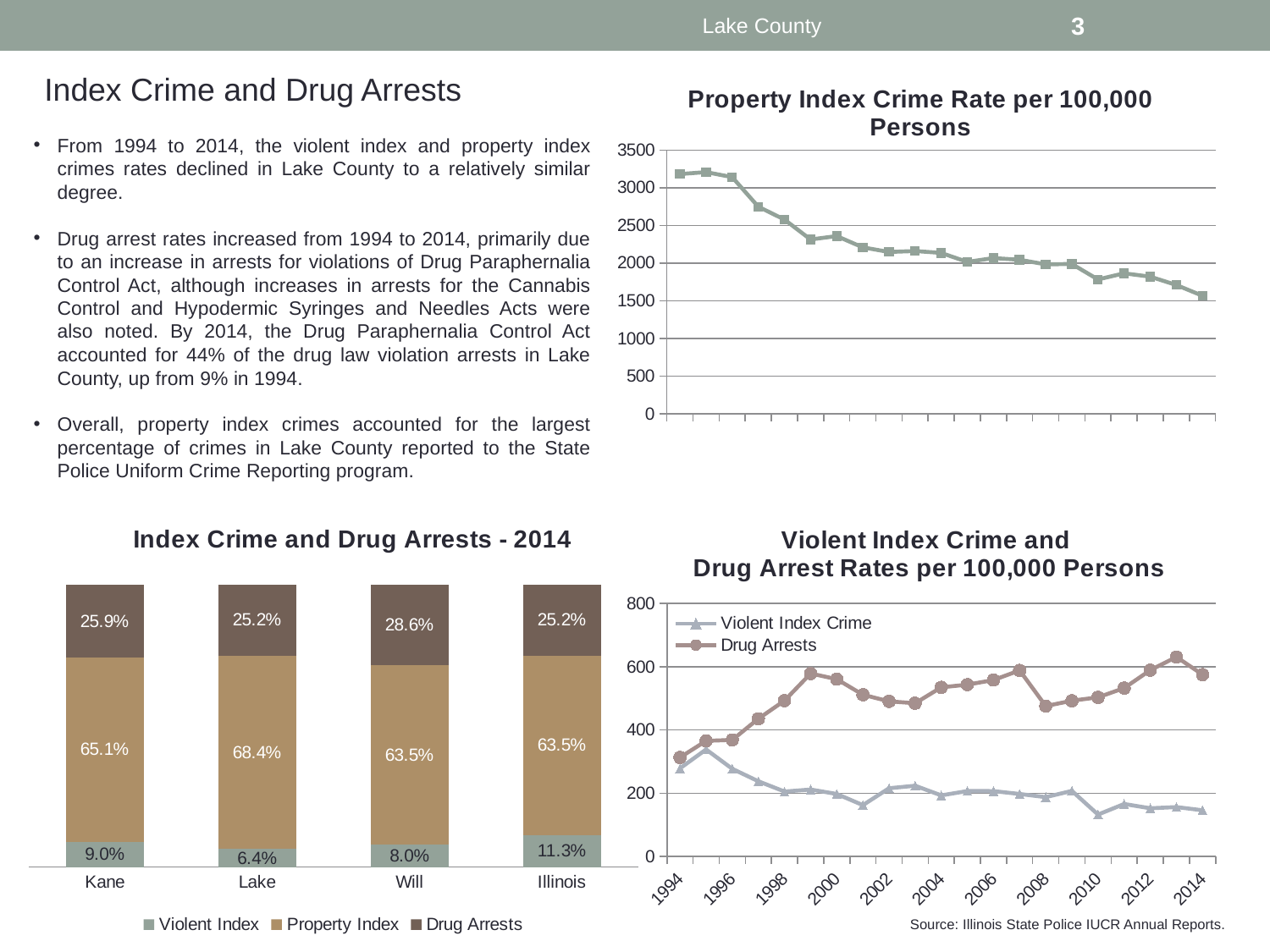
What kind of chart is 'Index Crime and Drug Arrests - 2014'? Stacked bar chart How many series does the legend of the 'Index Crime and Drug Arrests - 2014' chart list? 3 In the 'Violent Index Crime and Drug Arrest Rates per 100,000 Persons' chart, is the Violent Index Crime value for 2014 greater or less than 200? less How many categories are shown on the x axis of the 'Index Crime and Drug Arrests - 2014' chart? 4 In the 'Index Crime and Drug Arrests - 2014' chart, what percentage is shown for Violent Index in Illinois? 11.3% In the 'Index Crime and Drug Arrests - 2014' chart, what is the difference between the Drug Arrests percentage for Will and for Illinois? 3.4 percentage points In the 'Index Crime and Drug Arrests - 2014' chart, which has a larger Drug Arrests percentage, Kane or Will? Will In the 'Index Crime and Drug Arrests - 2014' chart, which category has the highest Property Index percentage? Lake In the 'Index Crime and Drug Arrests - 2014' chart, which category has the lowest Violent Index percentage? Lake In the 'Property Index Crime Rate per 100,000 Persons' chart, do the values generally rise or fall along the x axis? Fall In the 'Index Crime and Drug Arrests - 2014' chart, what percentage is shown for Property Index in Lake? 68.4% How many series does the legend of the 'Violent Index Crime and Drug Arrest Rates per 100,000 Persons' chart list? 2